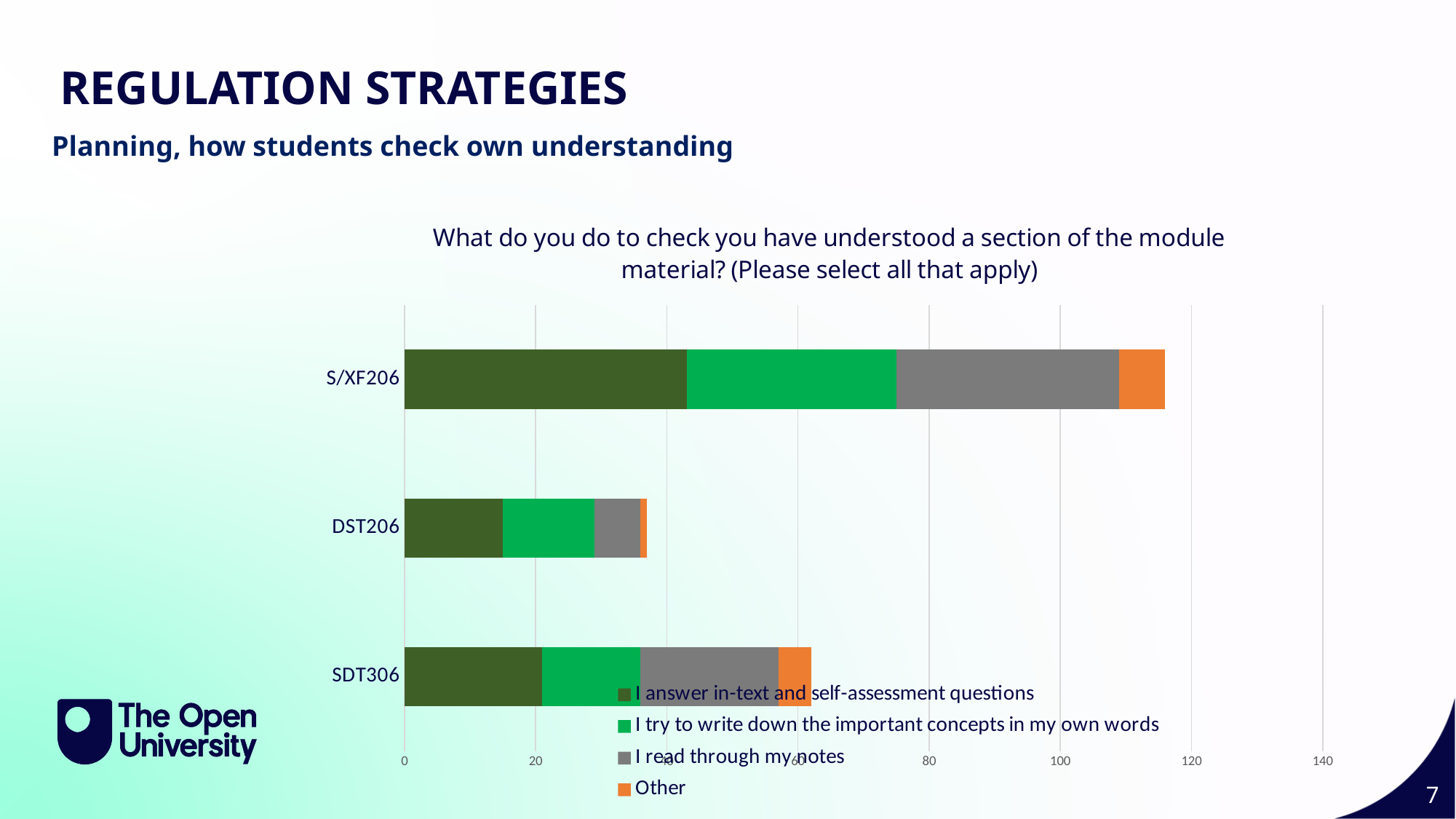
Which module has a longer total bar, S/XF206 or SDT306? S/XF206 Which module has the longest total bar? S/XF206 Is the total bar length for S/XF206 greater or less than 120? less What kind of chart is shown on the slide? bar chart Is the total bar length for SDT306 greater or less than 80? less Which colour represents the 'Other' series in the legend? orange Which module has a longer total bar, DST206 or SDT306? SDT306 Is the total bar length for S/XF206 greater or less than 100? greater Which module has the shortest total bar? DST206 How many series does the chart legend list? 4 How many module categories are plotted on the chart? 3